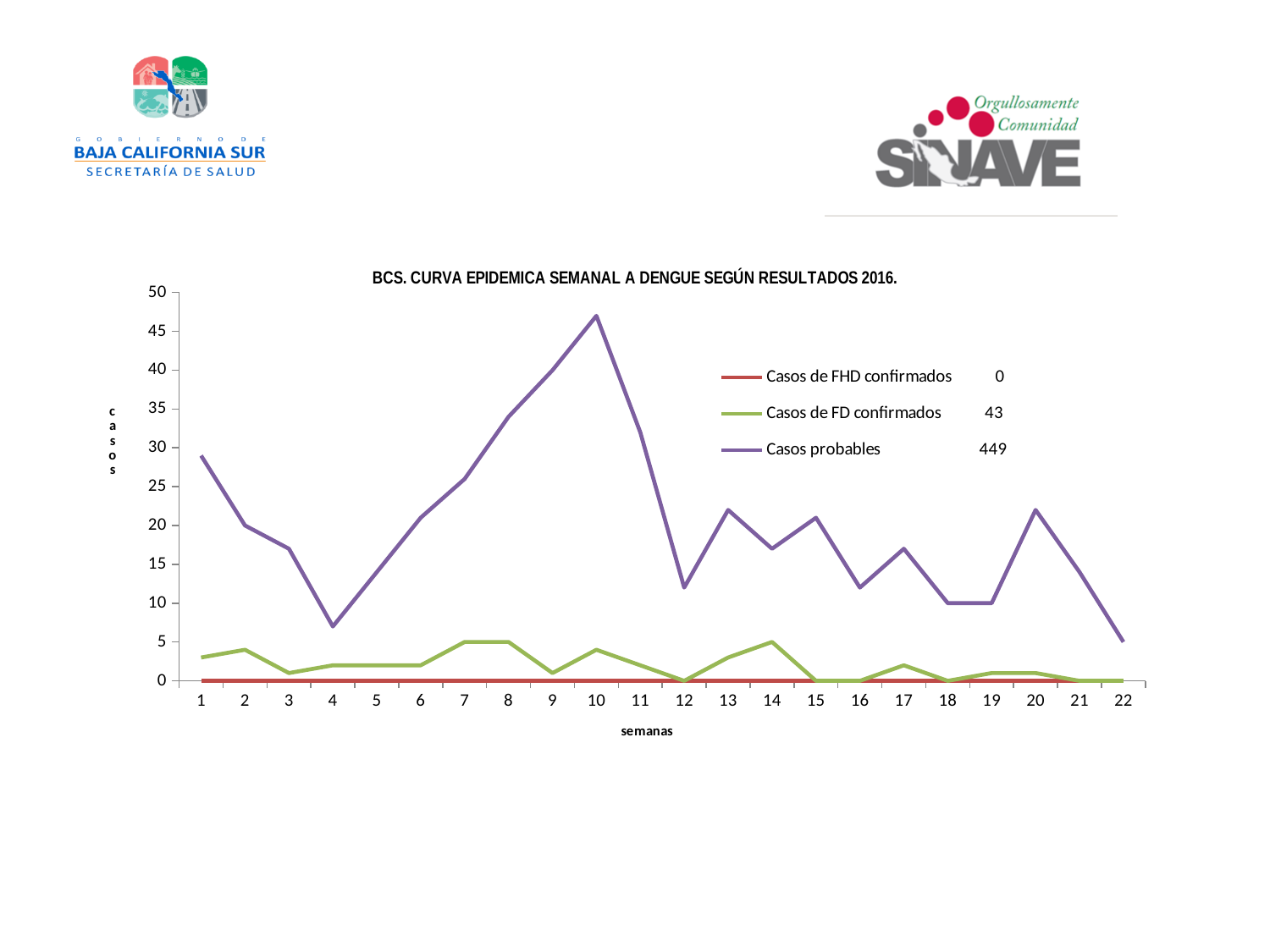
What total is printed next to Casos probables in the legend? 449 What is the label of the x axis? semanas In which week is the Casos probables series at its lowest value? 22 How many weeks (semanas) are plotted along the x axis? 22 What total is printed next to Casos de FHD confirmados in the legend? 0 What kind of chart is shown on the slide? line chart How many series does the legend list? 3 What total is printed next to Casos de FD confirmados in the legend? 43 In which week does the Casos probables series reach its highest value? 10 Is the value of Casos probables in week 4 greater or less than 10? less Is the value of Casos probables in week 10 greater or less than 45? greater For Casos probables, which week has the larger value, week 13 or week 14? week 13